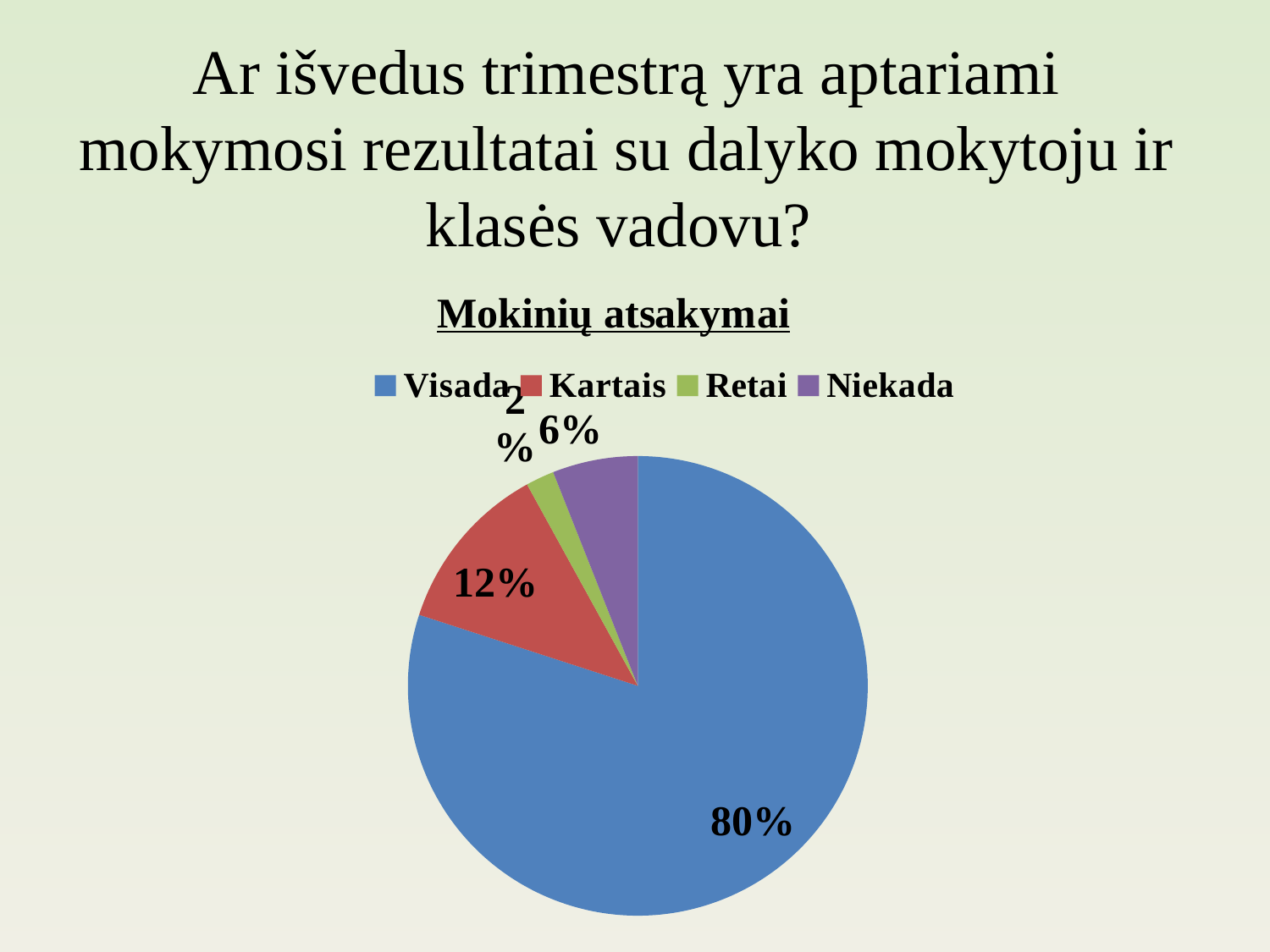
What colour is the Visada slice? blue Which category has the largest slice? Visada What share of the pie is Niekada? 6% Which category has the smallest slice? Retai What share of the pie is Visada? 80% What share of the pie is Retai? 2% What is the chart's title? Mokinių atsakymai What is the difference between the Visada and Kartais shares? 68% Which is larger, the Kartais slice or the Niekada slice? Kartais What kind of chart is shown on the slide? pie chart How many categories does the legend list? 4